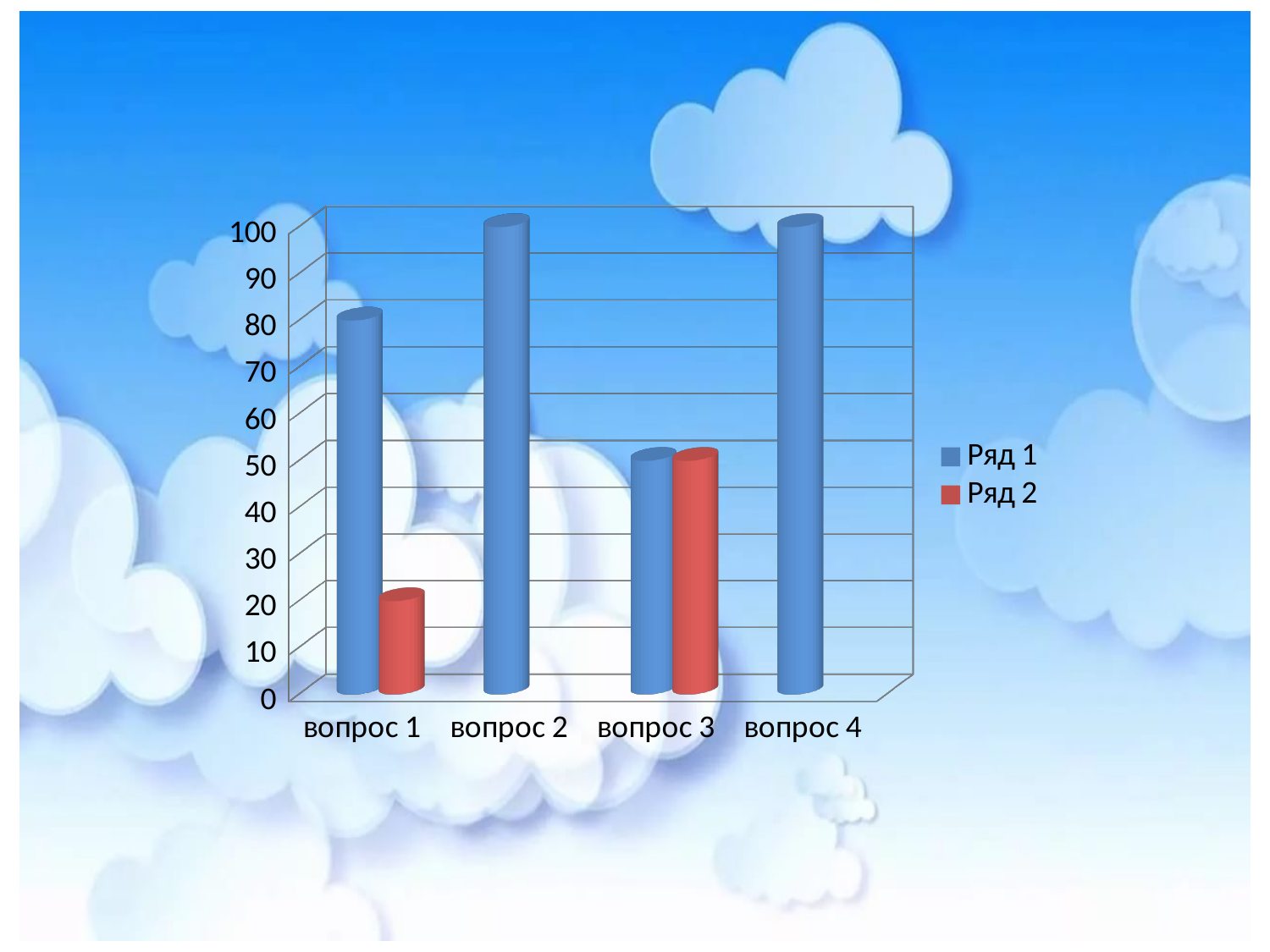
For which category is the value of Ряд 2 the highest? вопрос 3 For which category is the value of Ряд 1 the lowest? вопрос 3 How many series does the legend list? 2 Is the value of Ряд 1 for вопрос 3 greater or less than 70? less What kind of chart is shown on the slide? bar chart Is the value of Ряд 1 for вопрос 2 greater or less than 90? greater Is the value of Ряд 2 for вопрос 1 greater or less than 30? less For вопрос 1, which series has the larger value, Ряд 1 or Ряд 2? Ряд 1 How many categories are shown on the x axis? 4 Which series is shown in red in the legend? Ряд 2